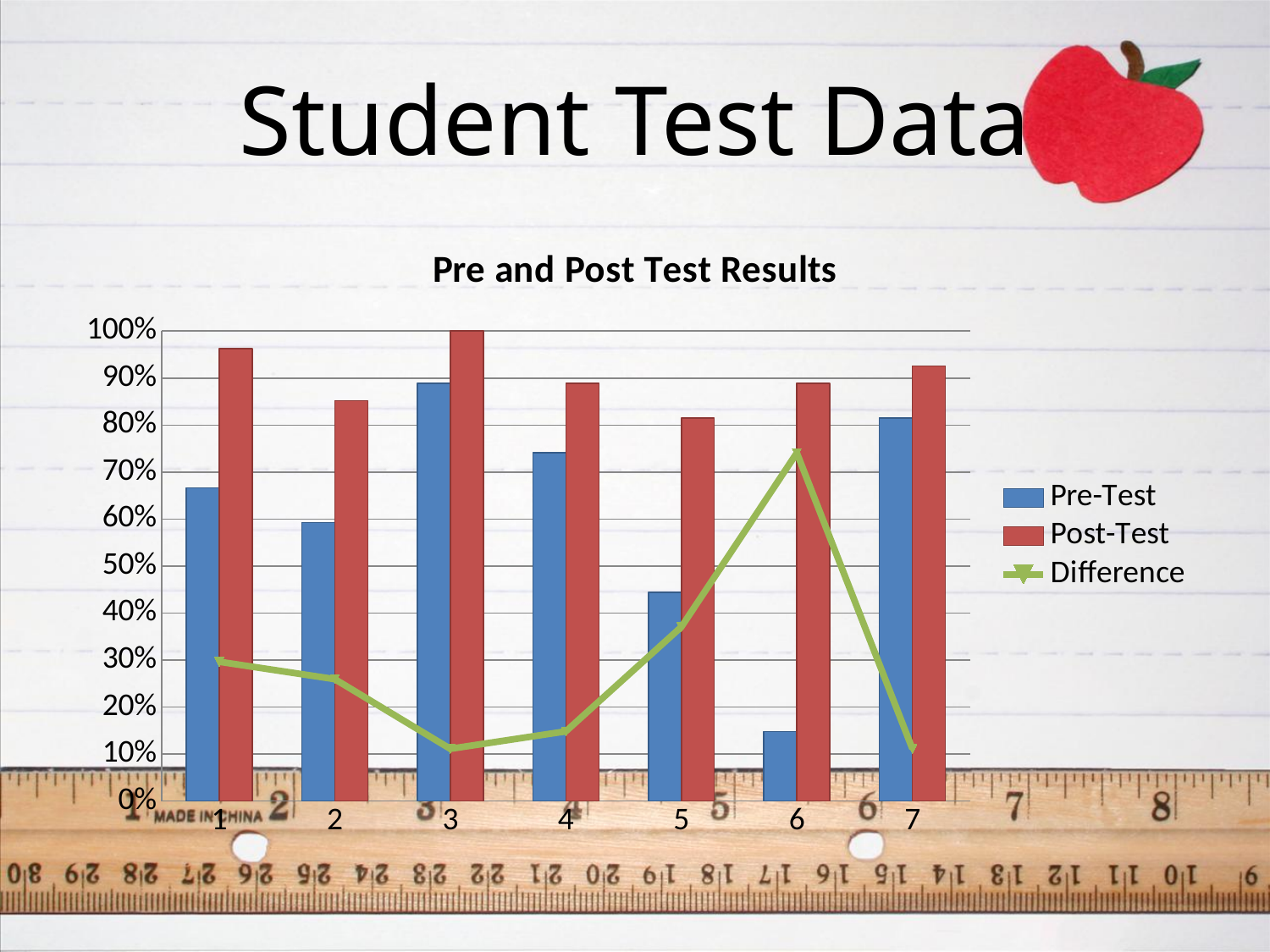
Is the Post-Test value for category 7 greater or less than 90%? greater Which category has the highest Post-Test value? 3 Which category has the highest Pre-Test value? 3 How many series does the legend list? 3 How many categories are shown on the x axis? 7 Which category has the lowest Pre-Test value? 6 What is the title of the chart? Pre and Post Test Results Which category has the highest Difference value? 6 Which is larger, the Pre-Test value for category 2 or the Pre-Test value for category 4? category 4 What kind of chart is shown on the slide? bar chart with a line What is the Post-Test value for category 3? 100% Is the Pre-Test value for category 5 greater or less than 50%? less